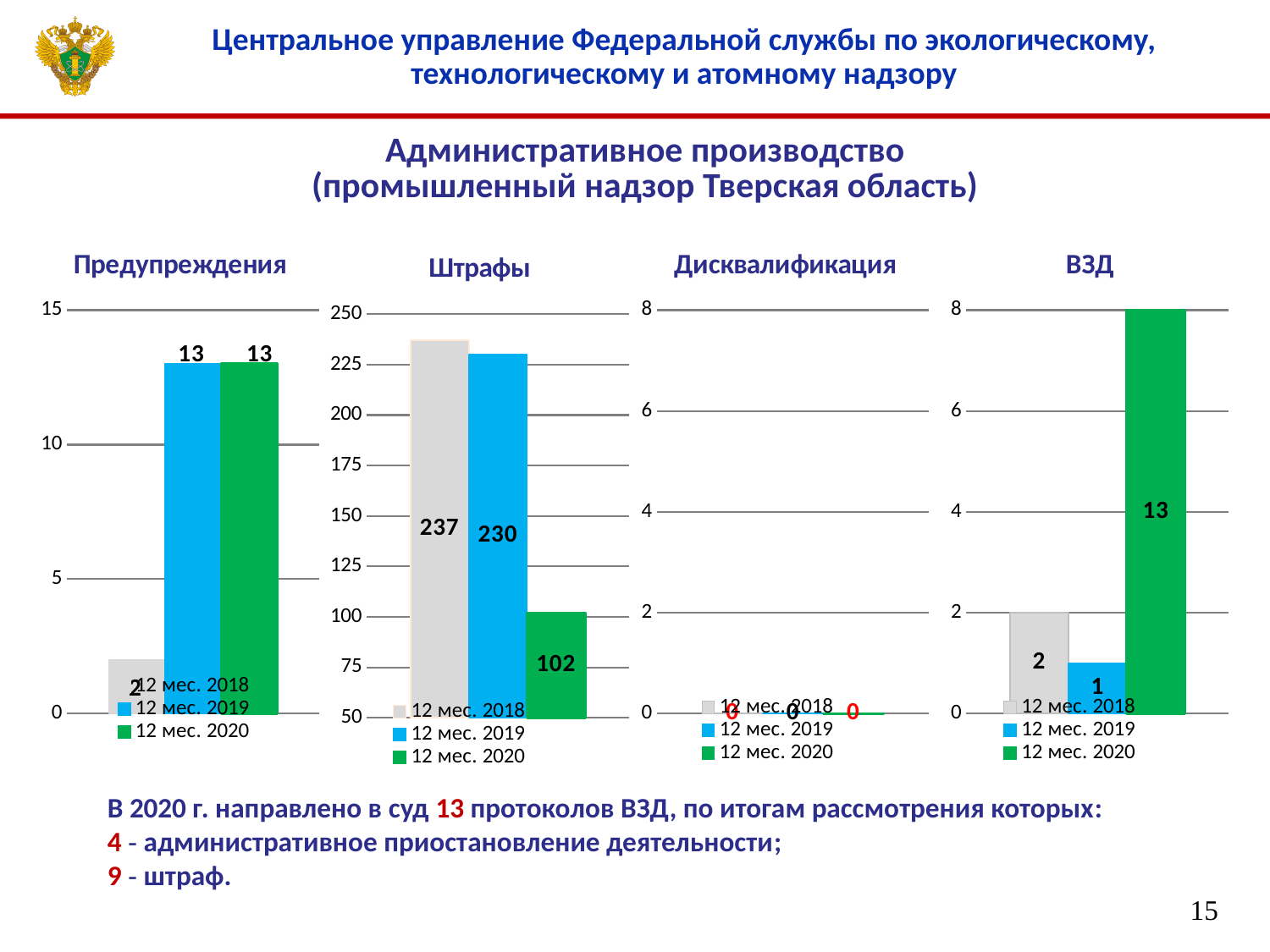
In the 'Штрафы' chart, is the value for 12 мес. 2019 greater or less than 200? greater In the 'ВЗД' chart, which is larger: the value for 12 мес. 2018 or 12 мес. 2019? 12 мес. 2018 In the 'ВЗД' chart, which period has the highest value? 12 мес. 2020 In the 'Штрафы' chart, what is the difference between the values for 12 мес. 2018 and 12 мес. 2020? 135 In the 'Штрафы' chart, do the values rise or fall from 12 мес. 2018 to 12 мес. 2020? fall In the 'Штрафы' chart, which period has the lowest value? 12 мес. 2020 In the 'ВЗД' chart, what is the value for 12 мес. 2020? 13 In the 'Штрафы' chart, what is the value for 12 мес. 2018? 237 In the 'Штрафы' chart, what is the value for 12 мес. 2020? 102 In the 'Предупреждения' chart, what is the value for 12 мес. 2018? 2 How many series does the legend of the 'Дисквалификация' chart list? 3 What kind of chart is the 'Предупреждения' chart? bar chart